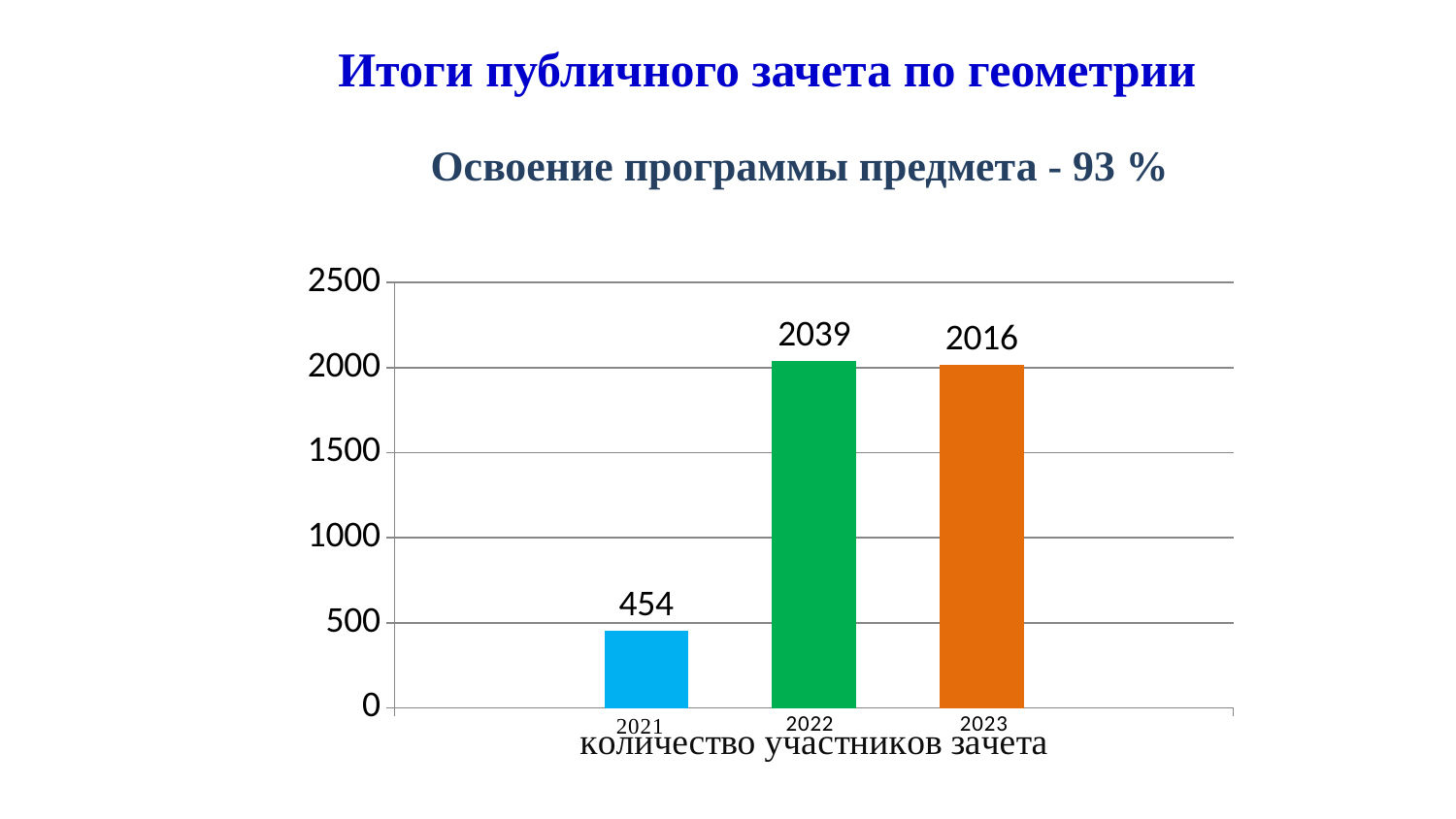
How many years are shown on the chart? 3 Which year has the lowest value? 2021 Which year has the highest value? 2022 Is the value for 2021 greater or less than 500? less What is the difference between the values for 2022 and 2021? 1585 What is the value for 2022? 2039 What is the value for 2023? 2016 What is the label below the x axis of the chart? количество участников зачета Which is larger, the value for 2021 or the value for 2023? 2023 What kind of chart is shown on the slide? bar chart What is the value for 2021? 454 What is the difference between the values for 2022 and 2023? 23